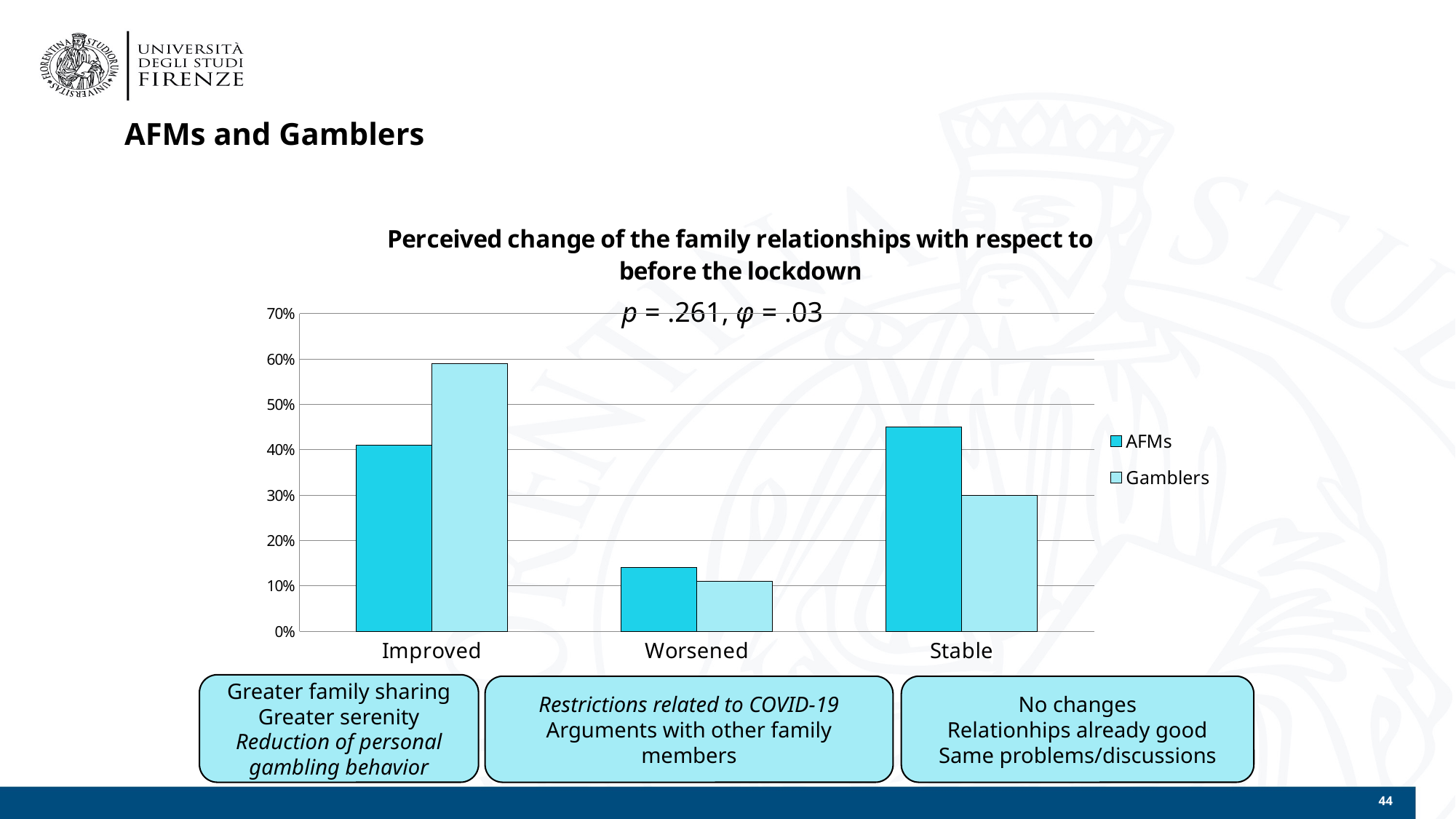
Is the value for Gamblers in the Improved category greater or less than 50%? greater How many categories are shown on the x axis? 3 For the Stable category, which series has the larger value, AFMs or Gamblers? AFMs What kind of chart is shown on the slide? bar chart Is the value for AFMs in the Worsened category greater or less than 20%? less Is the value for AFMs in the Stable category greater or less than 40%? greater What are the two series named in the legend? AFMs and Gamblers How many series does the legend list? 2 Which category has the highest value for AFMs? Stable Which category has the lowest value for AFMs? Worsened For the Improved category, which series has the larger value, AFMs or Gamblers? Gamblers Which category has the highest value for Gamblers? Improved